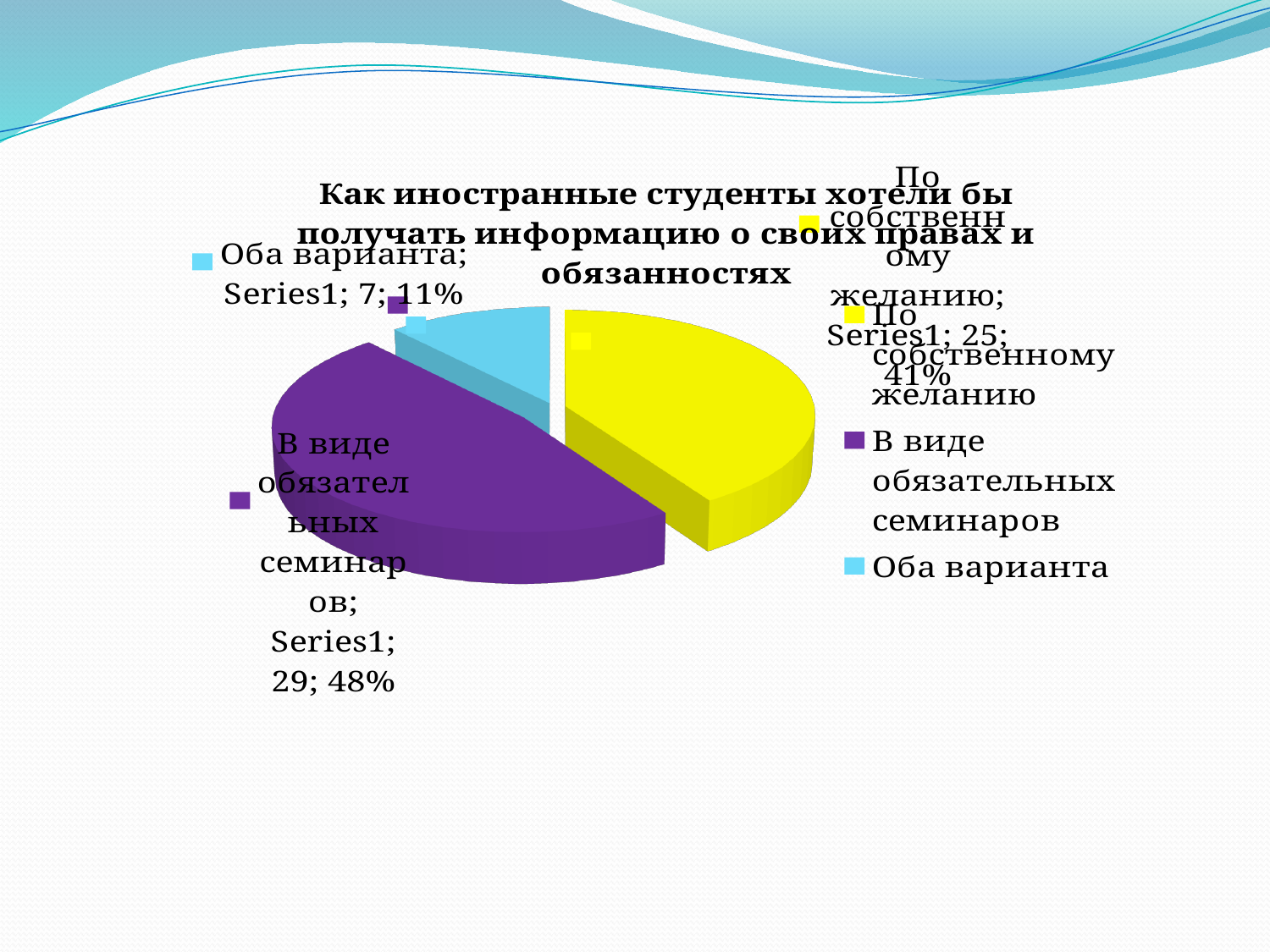
What colour is the slice for "Оба варианта"? light blue What percentage share of the pie does "Оба варианта" have? 11% What is the value for "В виде обязательных семинаров"? 29 What is the value for "Оба варианта"? 7 What is the difference between the values for "В виде обязательных семинаров" and "По собственному желанию"? 4 What percentage share of the pie does "В виде обязательных семинаров" have? 48% Which category has the largest slice? В виде обязательных семинаров What kind of chart is shown on the slide? pie chart What percentage share of the pie does "По собственному желанию" have? 41% Which category has the smallest slice? Оба варианта What is the value for "По собственному желанию"? 25 How many categories does the pie chart have? 3